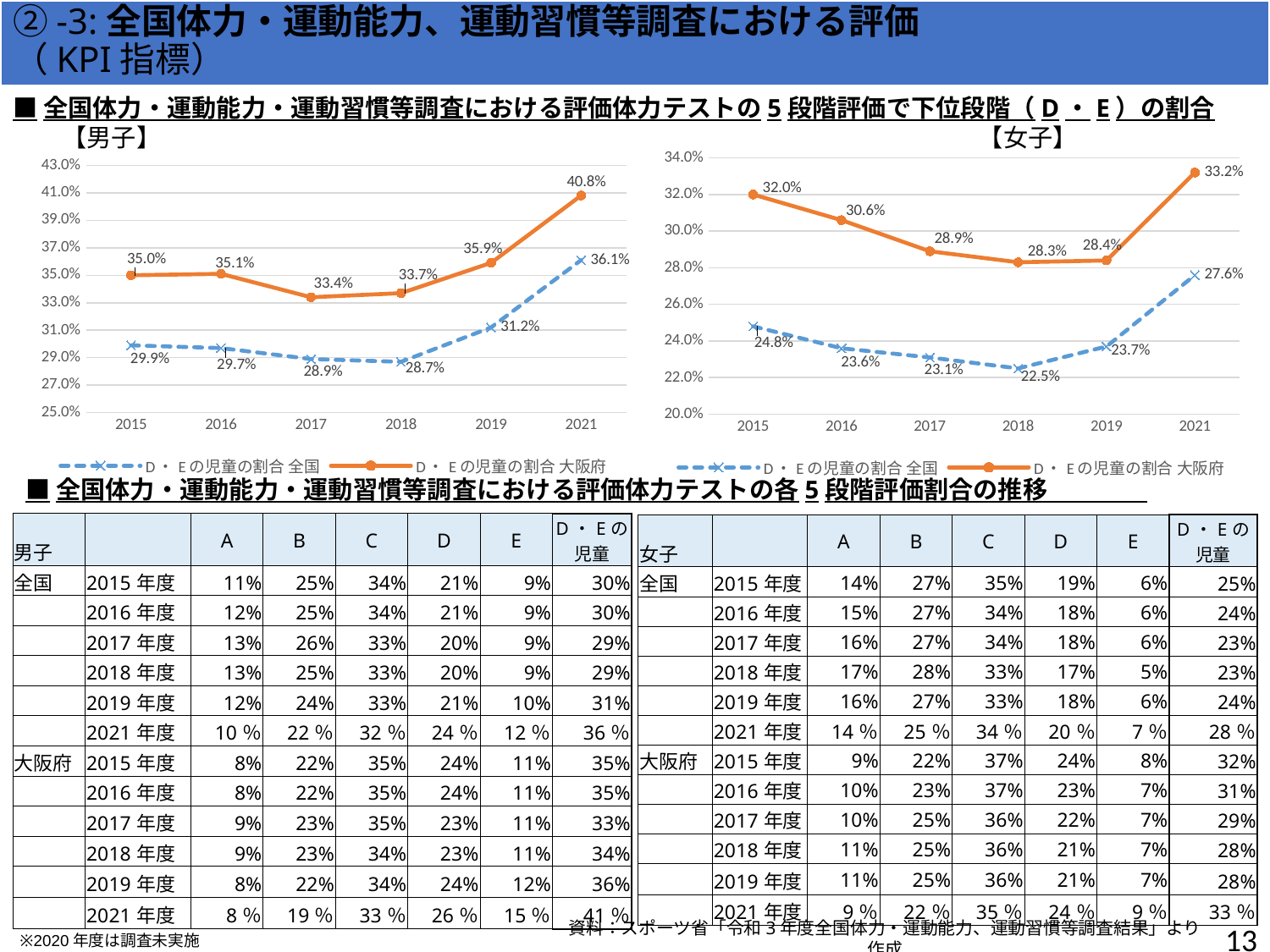
In the 【女子】 chart, in which year is the 大阪府 value highest? 2021 What type of chart is the 【女子】 chart? Line chart In the 【男子】 chart, what is the difference between the 大阪府 and 全国 values in 2021? 4.7% In the 【男子】 chart, is the 大阪府 value for 2021 greater or less than 39.0%? greater In the 【男子】 chart, what is the value for 全国 in 2019? 31.2% In the 【男子】 chart, what is the value for 大阪府 in 2021? 40.8% In the 【女子】 chart, what is the value for 全国 in 2018? 22.5% How many series does the legend of the 【男子】 chart list? 2 In the 【女子】 chart, which is larger in 2019: the 大阪府 value or the 全国 value? 大阪府 In the 【男子】 chart, in which year is the 全国 value lowest? 2018 How many years are plotted on the x axis of the 【女子】 chart? 6 In the 【女子】 chart, what is the difference between the 大阪府 values in 2015 and 2018? 3.7%